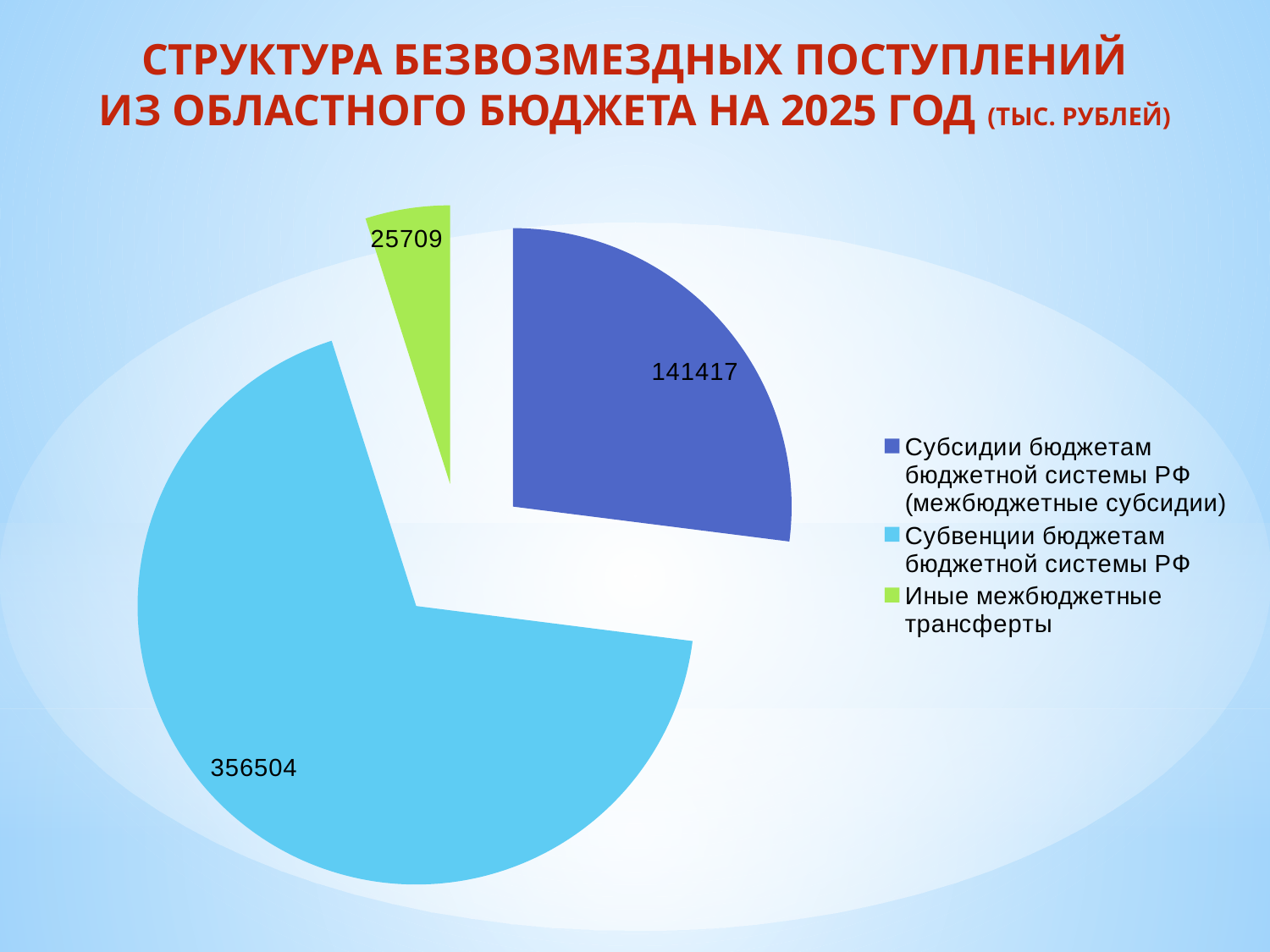
What is the value for Иные межбюджетные трансферты? 25709 What is the value for Субвенции бюджетам бюджетной системы РФ? 356504 What is the difference between the values for Субсидии бюджетам бюджетной системы РФ (межбюджетные субсидии) and Иные межбюджетные трансферты? 115708 What is the total of all three slices of the pie chart? 523630 Which category has the smallest slice of the pie? Иные межбюджетные трансферты How many slices does the pie chart have? 3 Which category has the largest slice of the pie? Субвенции бюджетам бюджетной системы РФ Which is larger: the value for Субсидии бюджетам бюджетной системы РФ (межбюджетные субсидии) or the value for Иные межбюджетные трансферты? Субсидии бюджетам бюджетной системы РФ (межбюджетные субсидии) What is the difference between the values for Субвенции бюджетам бюджетной системы РФ and Субсидии бюджетам бюджетной системы РФ (межбюджетные субсидии)? 215087 What is the value for Субсидии бюджетам бюджетной системы РФ (межбюджетные субсидии)? 141417 What kind of chart is shown on the slide? pie chart What colour is the slice for Иные межбюджетные трансферты? green